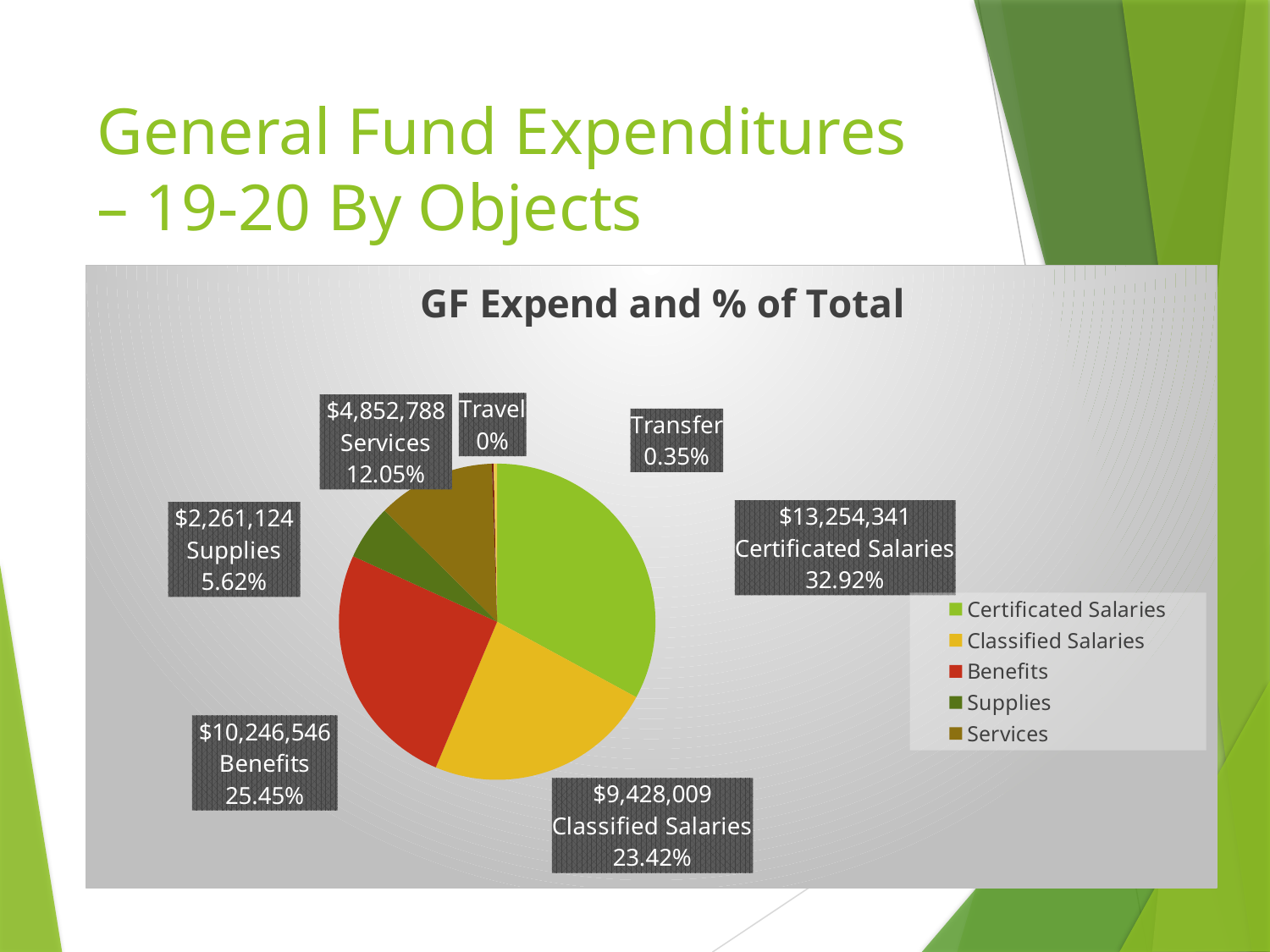
Which category has the largest share of the pie? Certificated Salaries What is the difference in dollars between Certificated Salaries and Classified Salaries? $3,826,332 How many entries does the legend list? 5 What is the title of the chart? GF Expend and % of Total What type of chart is shown on the slide? pie chart Which is larger, Benefits or Classified Salaries? Benefits What is the dollar value shown for Supplies? $2,261,124 What is the dollar value shown for Classified Salaries? $9,428,009 What percentage of the total is Benefits? 25.45% What percentage of the total is Services? 12.05% Which category has the smallest share of the pie? Travel What is the dollar value shown for Certificated Salaries? $13,254,341